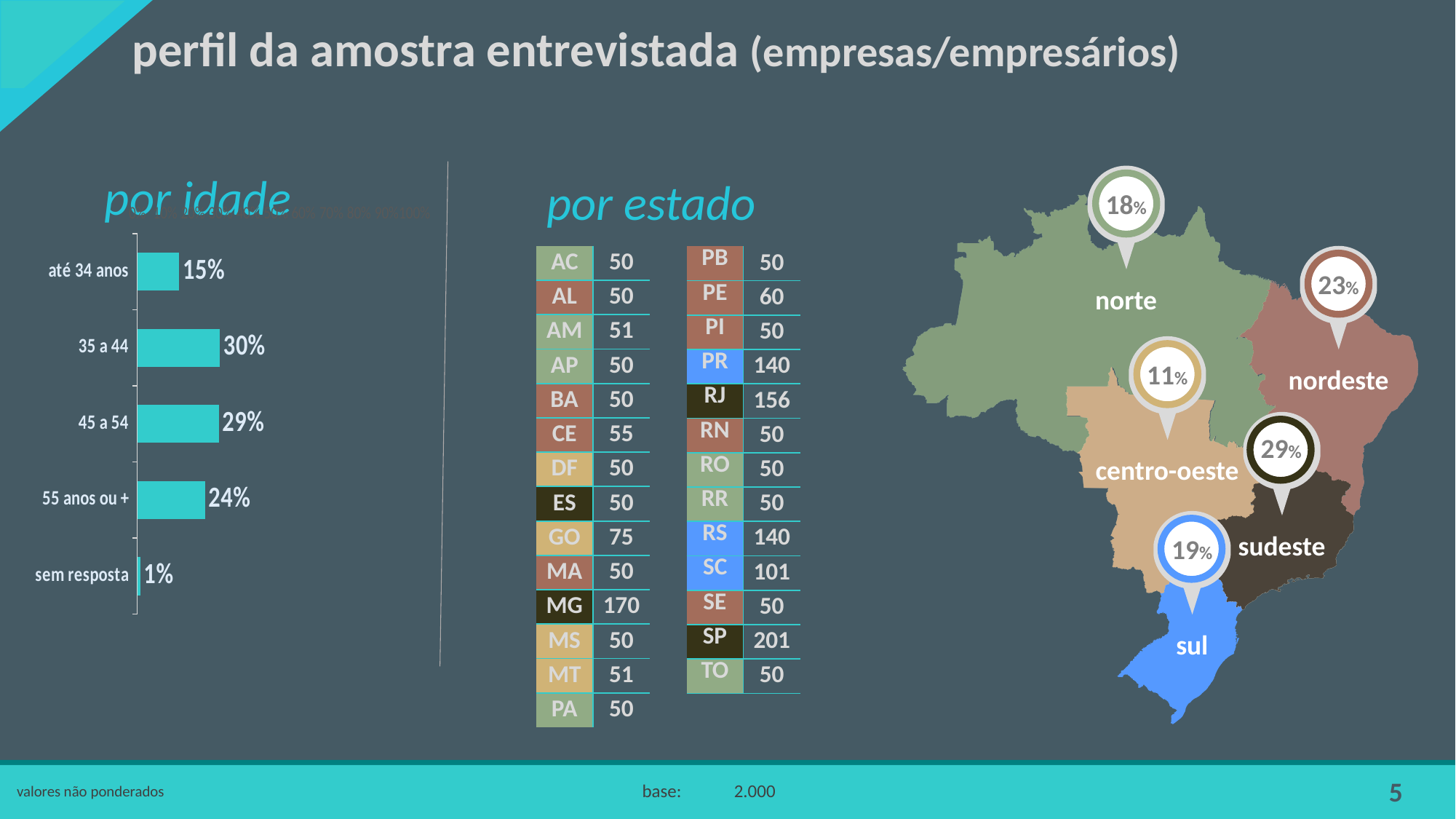
What kind of chart is the 'por idade' chart? bar chart In the 'por idade' chart, what is the value for '35 a 44'? 30% In the 'por idade' chart, which category has the highest value? 35 a 44 In the 'por idade' chart, what is the value for 'até 34 anos'? 15% In the 'por idade' chart, which category has the lowest value? sem resposta In the 'por idade' chart, what is the value for '55 anos ou +'? 24% How many categories does the 'por idade' chart show? 5 In the 'por idade' chart, what is the difference between the values for '45 a 54' and '55 anos ou +'? 5% In the 'por idade' chart, what is the value for 'sem resposta'? 1% What colour are the bars in the 'por idade' chart? teal In the 'por idade' chart, what is the difference between the values for '35 a 44' and 'até 34 anos'? 15% In the 'por idade' chart, which is larger: the value for '55 anos ou +' or the value for 'até 34 anos'? 55 anos ou +